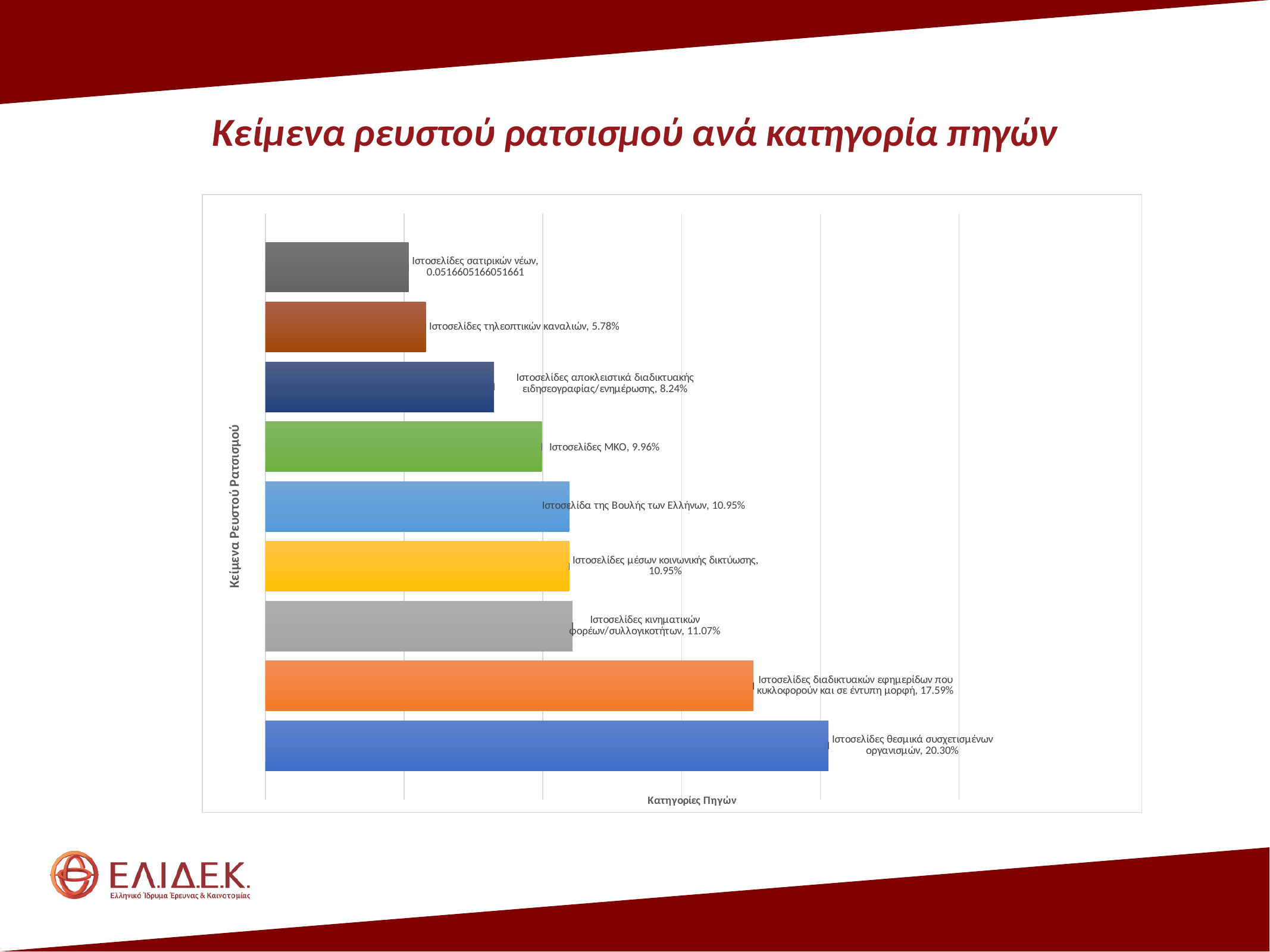
What is the difference between the values for Ιστοσελίδες θεσμικά συσχετισμένων οργανισμών and Ιστοσελίδες διαδικτυακών εφημερίδων που κυκλοφορούν και σε έντυπη μορφή? 2.71% Which is larger: the value for Ιστοσελίδες ΜΚΟ or for Ιστοσελίδες τηλεοπτικών καναλιών? Ιστοσελίδες ΜΚΟ How many categories (bars) does the chart show? 9 What is the title of the chart on the slide? Κείμενα ρευστού ρατσισμού ανά κατηγορία πηγών Which category has the lowest value? Ιστοσελίδες σατιρικών νέων Which category has the highest value? Ιστοσελίδες θεσμικά συσχετισμένων οργανισμών What is the value for Ιστοσελίδες διαδικτυακών εφημερίδων που κυκλοφορούν και σε έντυπη μορφή? 17.59% What is the value for Ιστοσελίδες κινηματικών φορέων/συλλογικοτήτων? 11.07% What is the value for Ιστοσελίδες θεσμικά συσχετισμένων οργανισμών? 20.30% What is the value for Ιστοσελίδες ΜΚΟ? 9.96% What is the value for Ιστοσελίδες τηλεοπτικών καναλιών? 5.78% What type of chart is shown on the slide? Bar chart